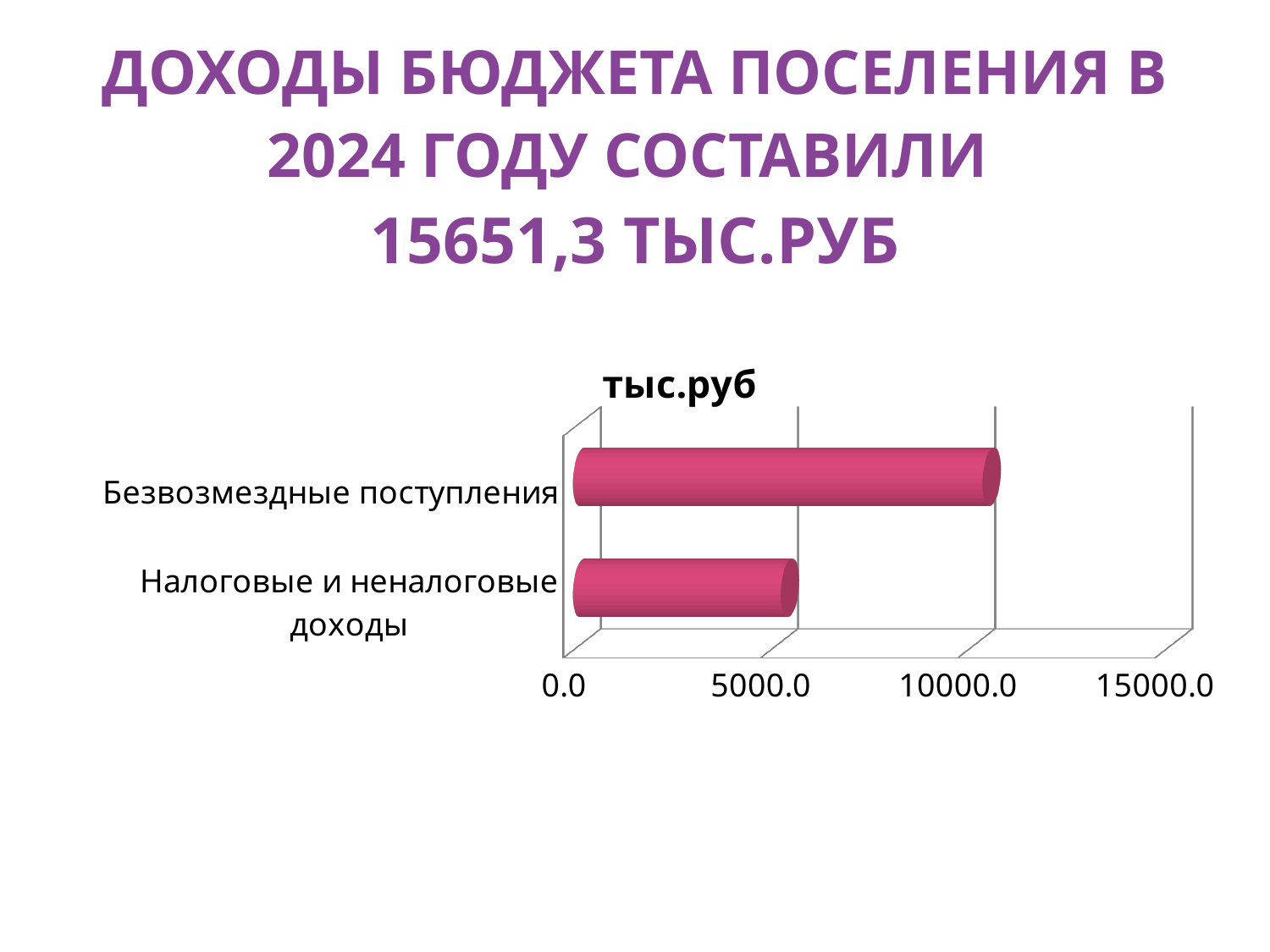
Is the value for Безвозмездные поступления greater or less than 15000.0? less Which category has the highest value? Безвозмездные поступления Is the value for Безвозмездные поступления greater or less than 5000.0? greater What colour are the bars in the chart? pink Is the value for Налоговые и неналоговые доходы greater or less than 10000.0? less Which is larger, Безвозмездные поступления or Налоговые и неналоговые доходы? Безвозмездные поступления What kind of chart is shown on the slide? bar chart Which category has the lowest value? Налоговые и неналоговые доходы What is the title of the chart? тыс.руб How many categories does the chart show? 2